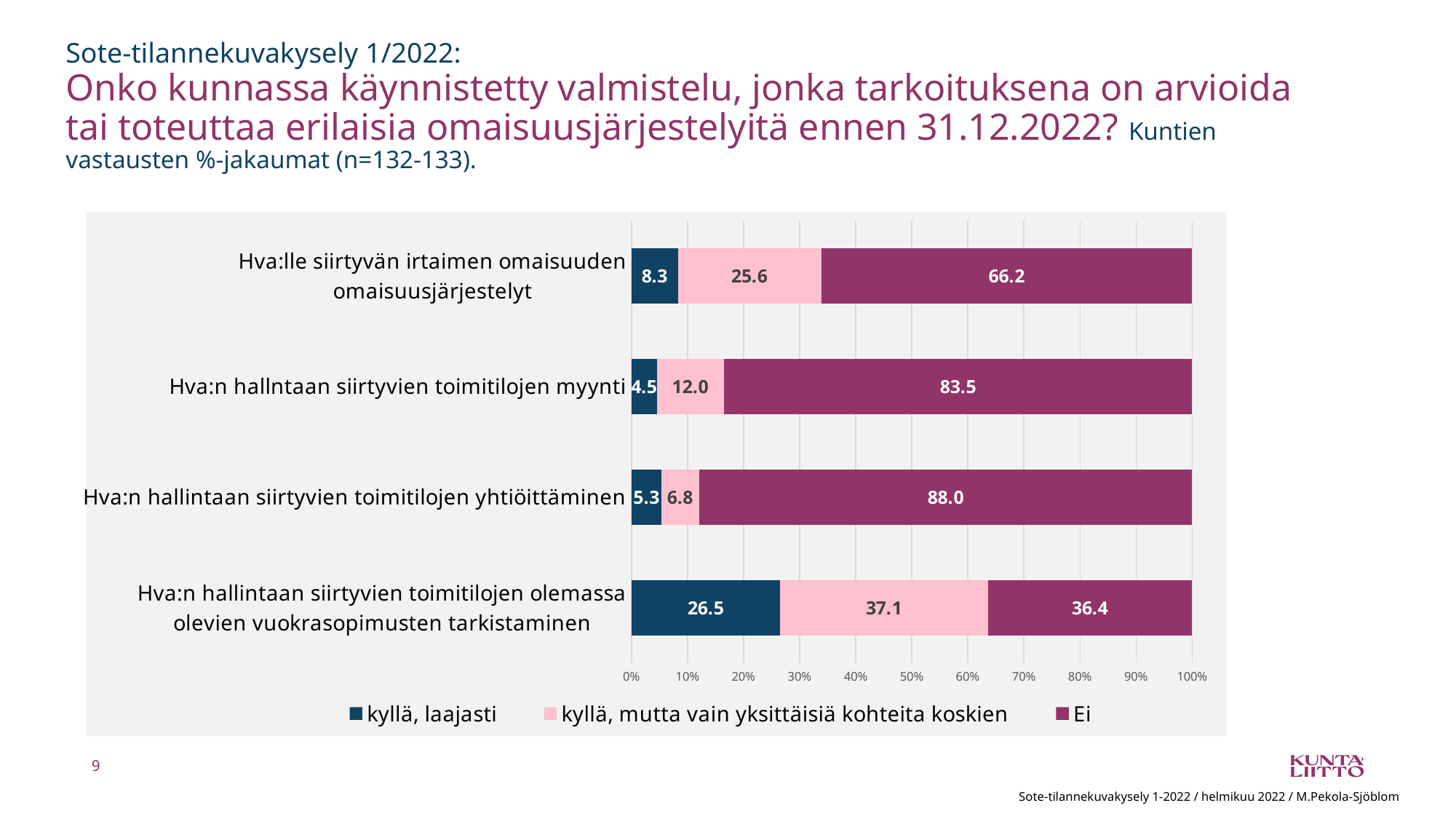
What is the difference between the "Ei" values for "Hva:n hallntaan siirtyvien toimitilojen myynti" and "Hva:lle siirtyvän irtaimen omaisuuden omaisuusjärjestelyt"? 17.3 Which category has the highest "Ei" value? Hva:n hallintaan siirtyvien toimitilojen yhtiöittäminen What is the total of the stacked bar for "Hva:n hallntaan siirtyvien toimitilojen myynti"? 100.0 What kind of chart is shown on the slide? Stacked bar chart How many categories are plotted on the chart? 4 How many series does the legend list? 3 Which category has the lowest "kyllä, laajasti" value? Hva:n hallntaan siirtyvien toimitilojen myynti What is the "kyllä, laajasti" value for "Hva:n hallintaan siirtyvien toimitilojen olemassa olevien vuokrasopimusten tarkistaminen"? 26.5 Which colour represents the "Ei" series in the chart? Dark purple Which is larger for "Hva:n hallintaan siirtyvien toimitilojen olemassa olevien vuokrasopimusten tarkistaminen": the "kyllä, mutta vain yksittäisiä kohteita koskien" value or the "Ei" value? kyllä, mutta vain yksittäisiä kohteita koskien What is the "kyllä, mutta vain yksittäisiä kohteita koskien" value for "Hva:lle siirtyvän irtaimen omaisuuden omaisuusjärjestelyt"? 25.6 What is the "Ei" value for "Hva:n hallintaan siirtyvien toimitilojen yhtiöittäminen"? 88.0